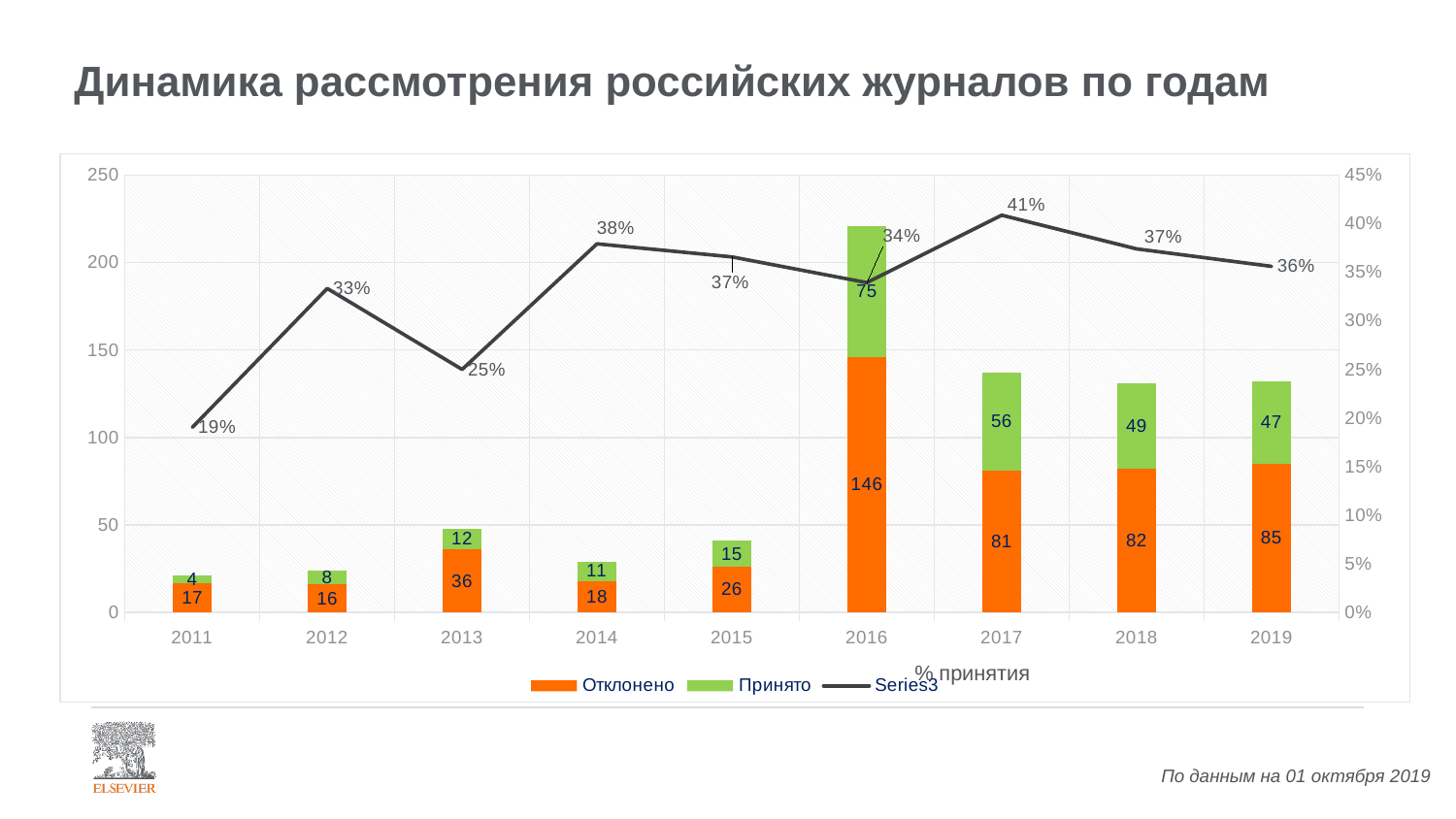
What is the value of Принято for 2017? 56 How many years are shown on the x axis? 9 What is the difference between the Отклонено values for 2019 and 2018? 3 Which is larger, the Принято value for 2013 or for 2015? 2015 Which year has the lowest Принято value? 2011 What is the total of the stacked bar for 2016? 221 How many series does the legend list? 3 What percentage does the line series show for 2014? 38% Which year has the highest Отклонено value? 2016 In which year does the line series reach its highest percentage? 2017 What is the value of Отклонено for 2016? 146 What is the title of the chart? Динамика рассмотрения российских журналов по годам